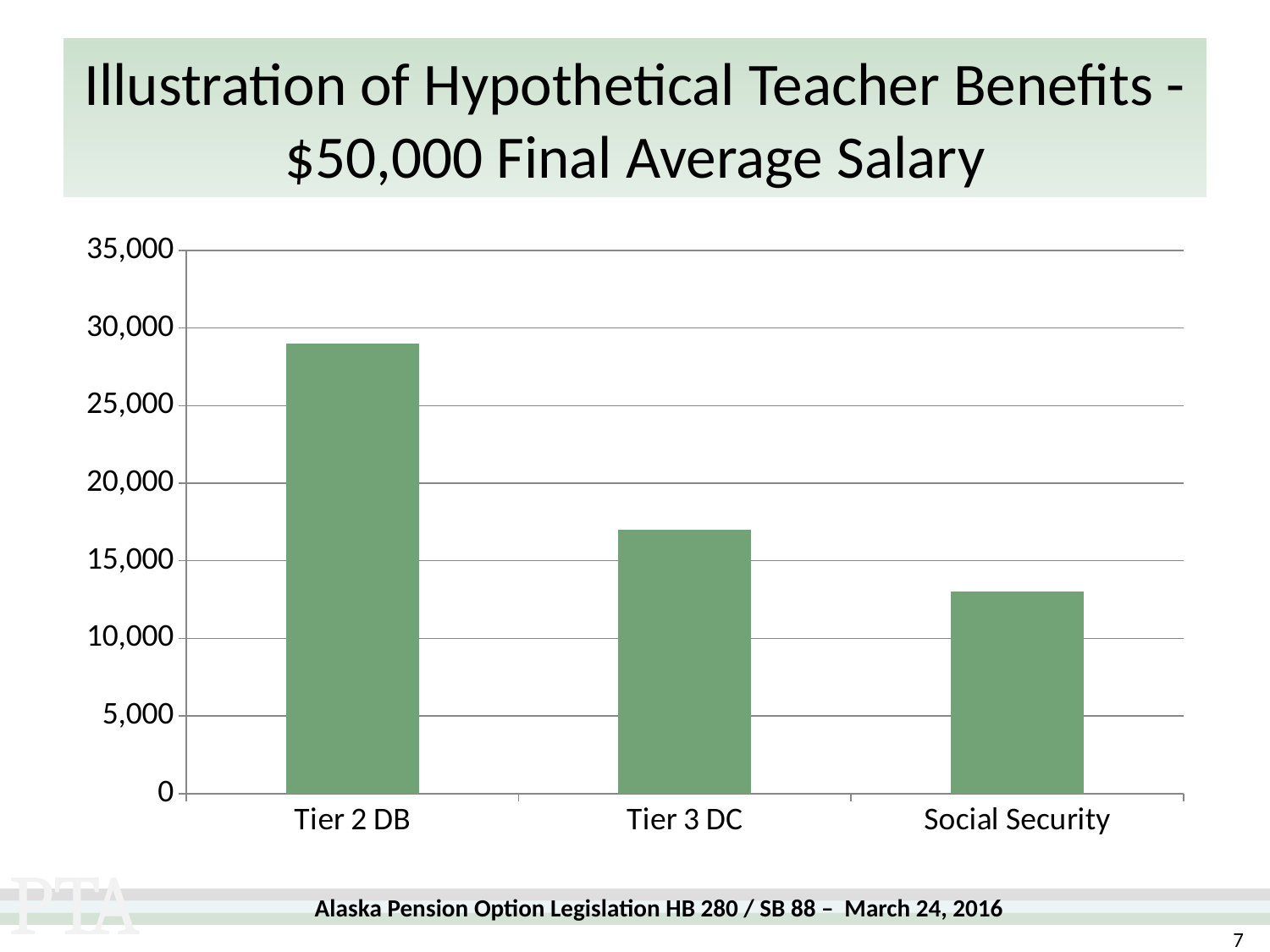
What kind of chart is shown on the slide? bar chart Which category has the lowest value? Social Security Which category has the highest value? Tier 2 DB What is the title of the slide containing the chart? Illustration of Hypothetical Teacher Benefits - $50,000 Final Average Salary Do the values rise or fall moving from left to right across the categories? fall Is the value for Social Security greater or less than 15,000? less Is the value for Tier 3 DC greater or less than 15,000? greater Which is larger, the value for Tier 2 DB or the value for Tier 3 DC? Tier 2 DB Is the value for Tier 2 DB greater or less than 30,000? less Which is larger, the value for Tier 3 DC or the value for Social Security? Tier 3 DC How many categories are plotted on the chart? 3